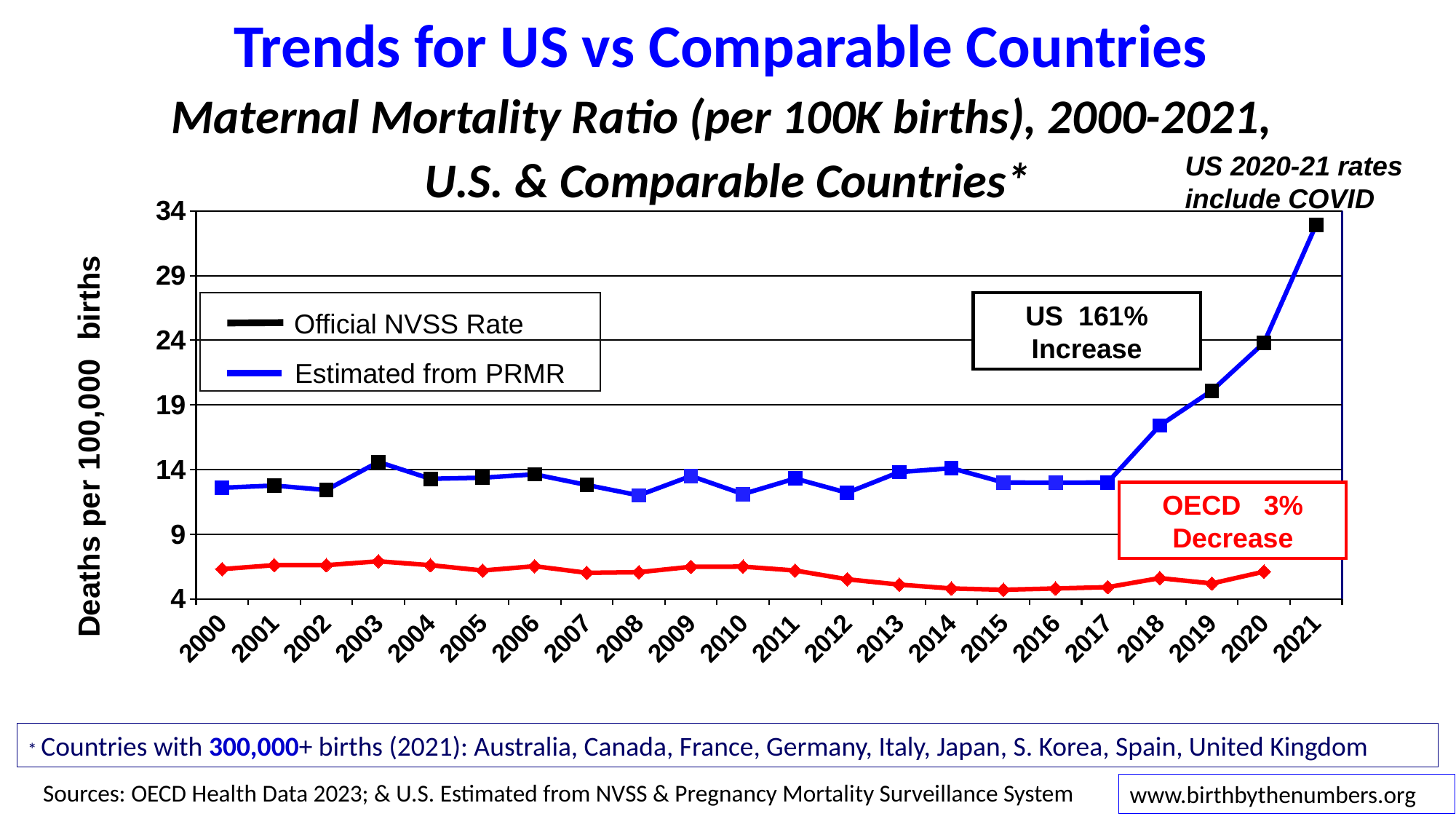
How many series does the chart's legend list? 2 Is the US value for 2021 greater or less than 29? greater Is the comparable countries (red line) value for 2003 greater or less than 9? less In 2010, which line is higher: the blue US line or the red comparable countries line? The blue US line What kind of chart is shown on the slide? Line chart Is the US value for 2008 greater or less than 14? less What percentage increase for the US is stated in the annotation box on the chart? 161% How many years are shown on the x axis of the chart? 22 Does the US line rise or fall from 2017 to 2021? Rise Which is larger, the US value in 2021 or the US value in 2000? 2021 In which year does the US line reach its highest value? 2021